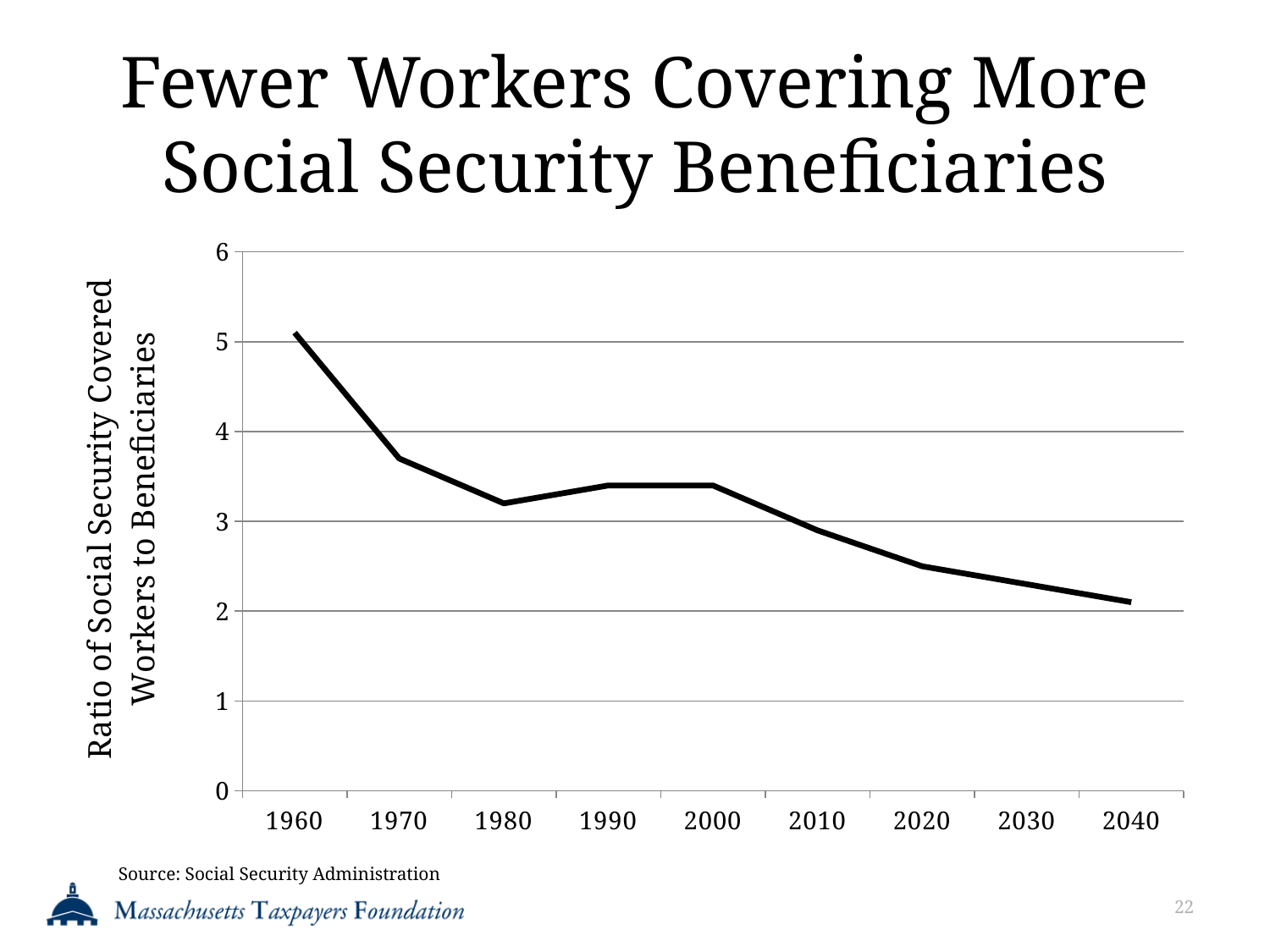
Which year has the lowest ratio of covered workers to beneficiaries? 2040 What is the label on the vertical axis? Ratio of Social Security Covered Workers to Beneficiaries Overall, does the ratio rise or fall from 1960 to 2040? fall Which is larger, the value for 1960 or the value for 1970? 1960 Is the value for 2040 greater or less than 3? less Is the value for 1980 greater or less than 3? greater Is the value for 1960 greater or less than 4? greater Which year has the highest ratio of covered workers to beneficiaries? 1960 What kind of chart is shown on the slide? line chart Which is larger, the value for 2000 or the value for 2020? 2000 How many years are plotted along the x axis? 9